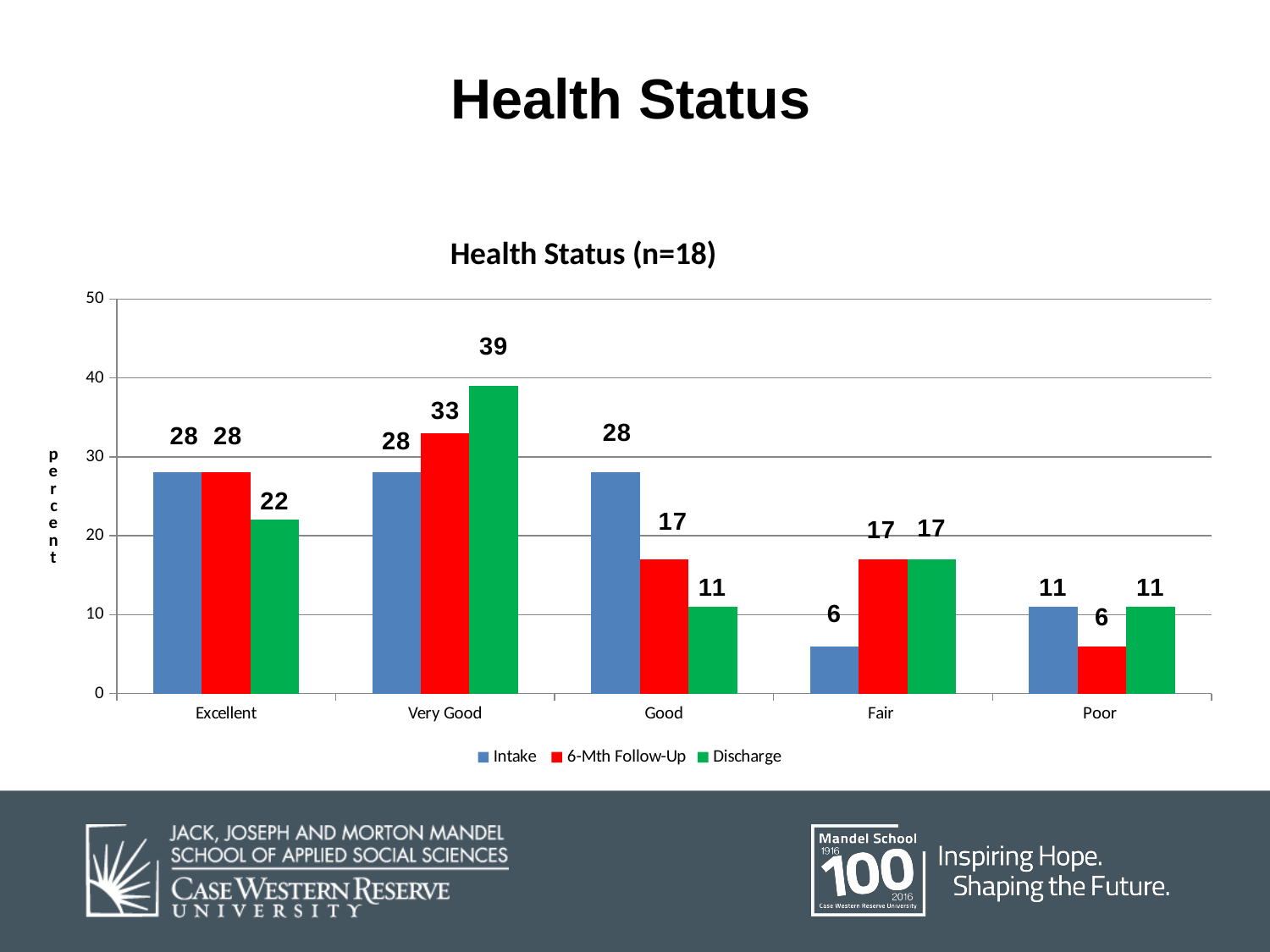
What is the 6-Mth Follow-Up value for Good? 17 What is the difference between the Discharge and Intake values for Very Good? 11 Which category has the lowest Intake value? Fair How many health status categories are shown on the x axis? 5 What is the title of the chart? Health Status (n=18) What is the Discharge value for Very Good? 39 Which category has the highest Discharge value? Very Good How many series does the legend list? 3 What is the Intake value for Fair? 6 Is the 6-Mth Follow-Up value for Very Good greater or less than 30? greater Which is larger for Excellent: the Intake value or the Discharge value? Intake What kind of chart is shown? Bar chart